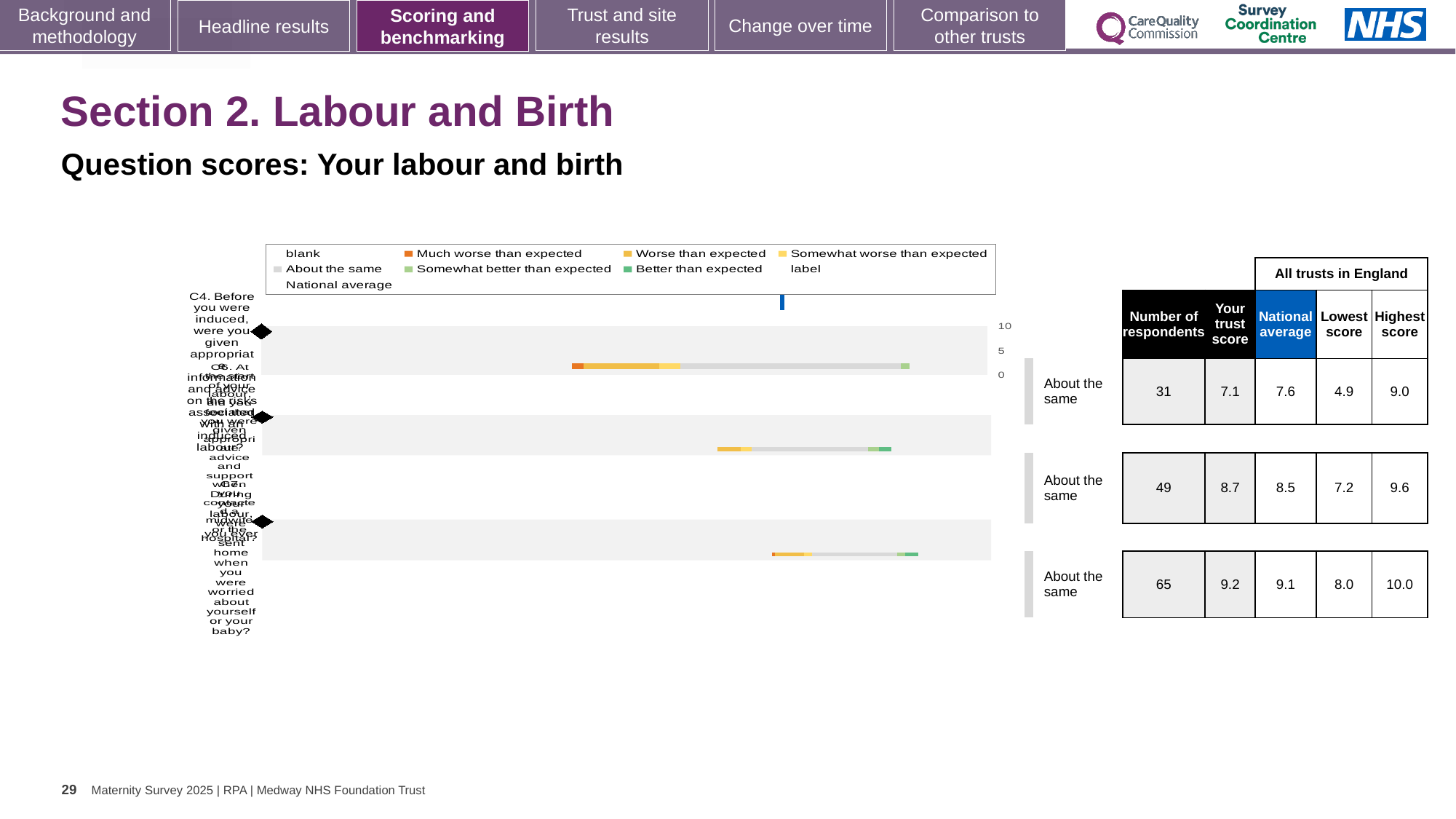
What is the highest tick value shown on the chart's axis? 10 Which legend entry is shown in orange? Much worse than expected Which bar in the chart starts furthest to the left: the top, middle or bottom bar? top Which bar in the chart starts furthest to the right: the top, middle or bottom bar? bottom What kind of chart is shown on the slide? bar chart Which legend entry is shown in dark green? Better than expected How many horizontal bars are plotted in the chart? 3 How many entries does the chart legend list? 9 Which bar in the chart contains an orange 'Much worse than expected' segment: the top, middle or bottom bar? top